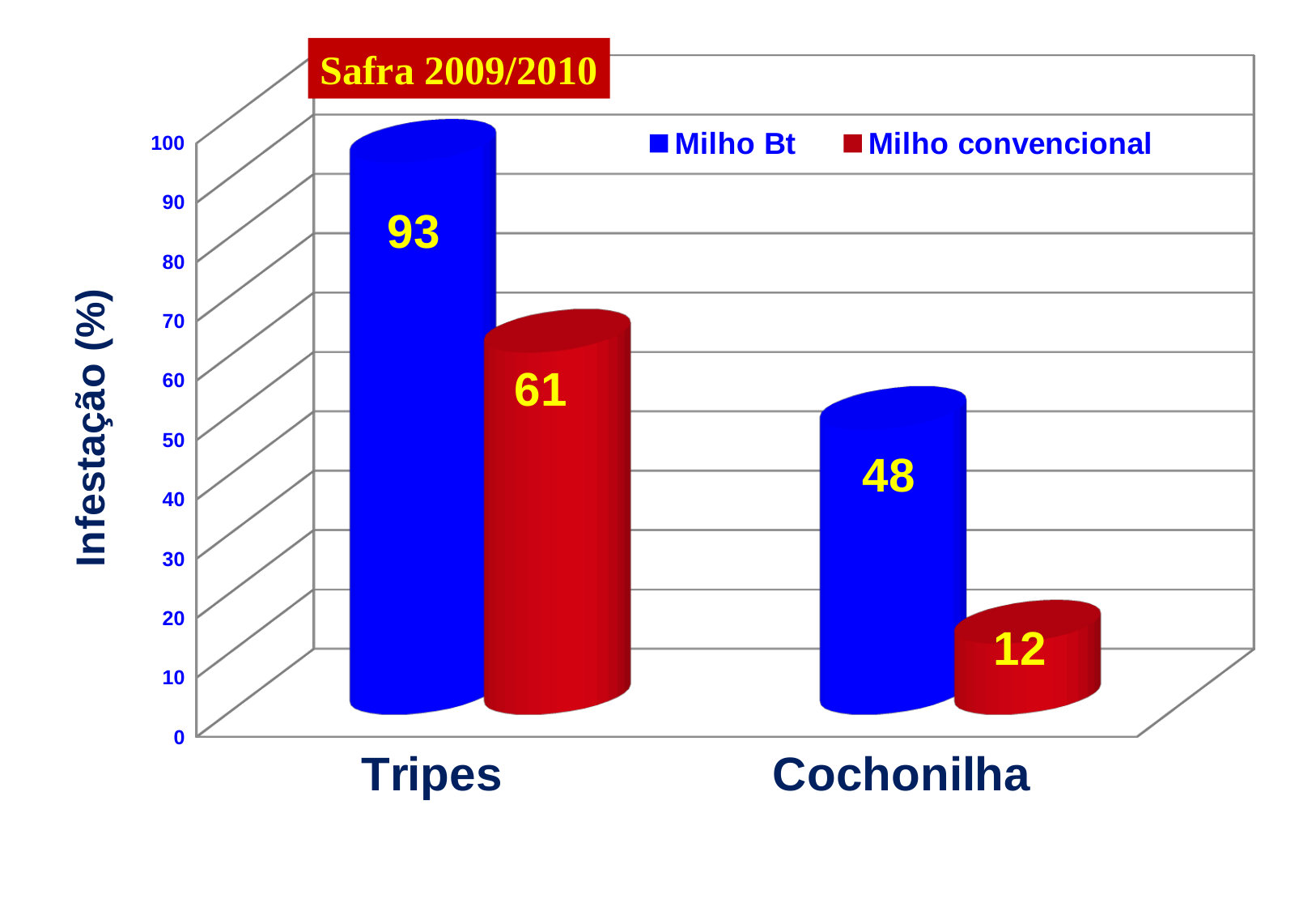
Which category has the highest Milho Bt value? Tripes What is the infestation value for Milho convencional in the Cochonilha category? 12 What is the difference between the Milho Bt and Milho convencional values for Cochonilha? 36 Which category has the lowest Milho convencional value? Cochonilha What is the infestation value for Milho convencional in the Tripes category? 61 How many categories are shown on the x axis? 2 What kind of chart is shown on the slide? Bar chart What is the difference between the Milho Bt and Milho convencional values for Tripes? 32 How many series does the legend list? 2 What is the infestation value for Milho Bt in the Cochonilha category? 48 Which is larger for Cochonilha: Milho Bt or Milho convencional? Milho Bt What is the infestation value for Milho Bt in the Tripes category? 93